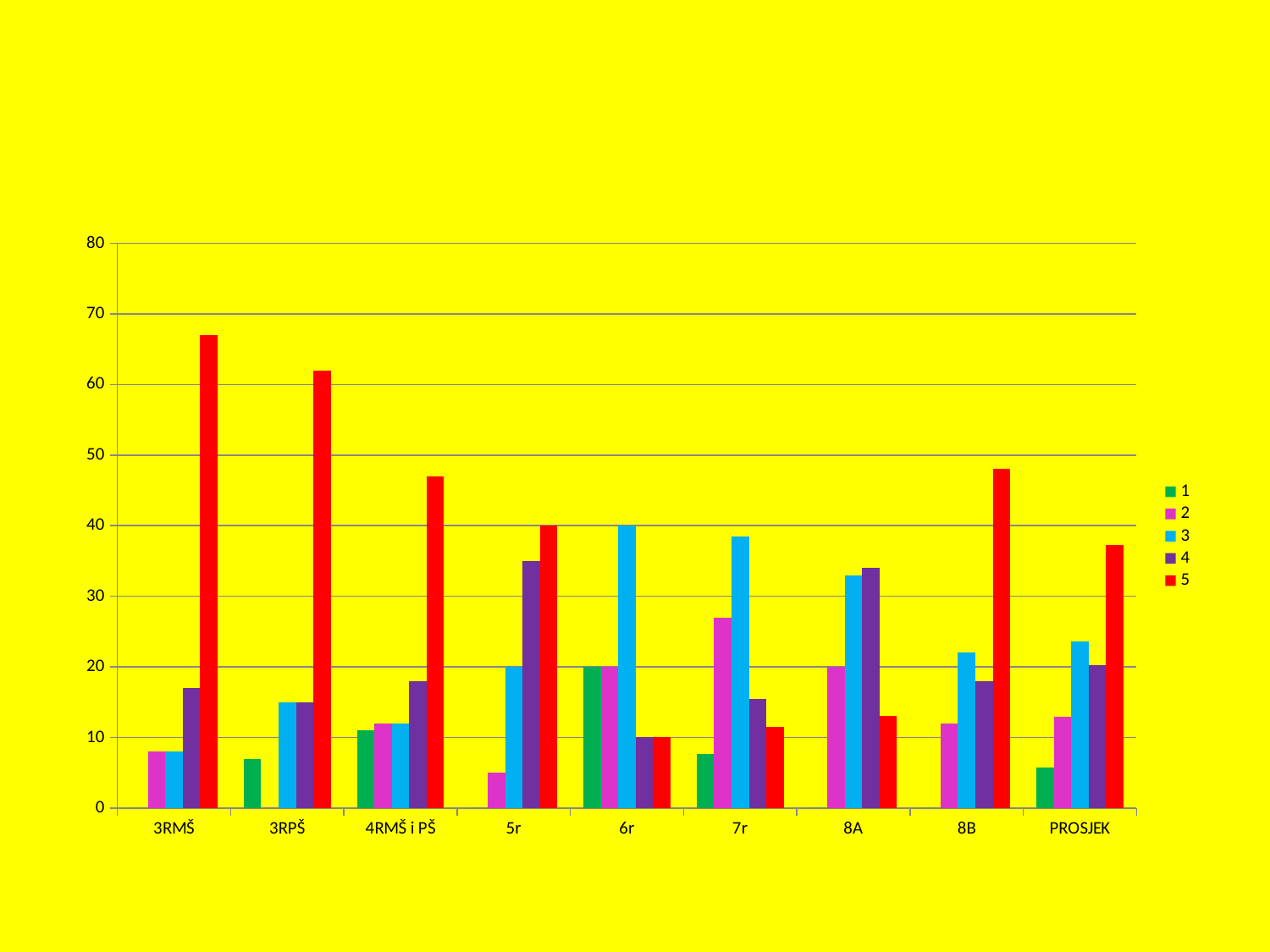
How many series does the legend list? 5 Is the value for series 4 in 5r greater or less than 30? greater How many categories are shown along the x axis? 9 What kind of chart is shown on the slide? bar chart What are the entries listed in the legend? 1, 2, 3, 4, 5 Is the value for series 5 in 8B greater or less than 50? less Which category has the highest value for series 5? 3RMŠ In the 6r category, which is larger: series 3 or series 4? series 3 In the PROSJEK category, which series has the highest value? 5 Is the value for series 5 in 3RPŠ greater or less than 60? greater In the 7r category, which series has the highest value? 3 What is the value for series 3 in the 6r category? 40